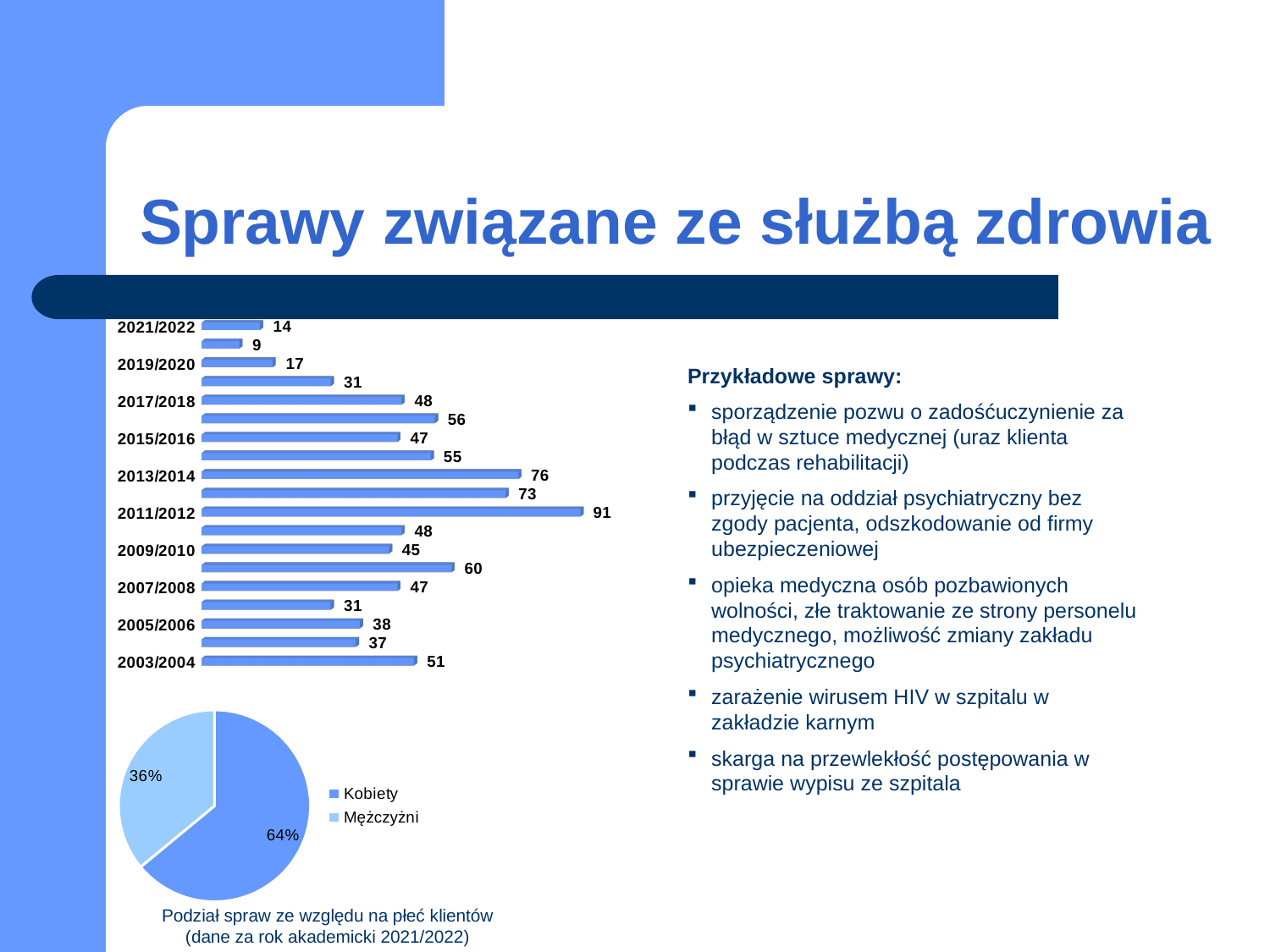
In the bar chart, do the values rise or fall from 2011/2012 to 2021/2022? fall In the pie chart, what share is Mężczyźni? 36% How many entries does the legend of the pie chart list? 2 In the bar chart, what is the difference between the values for 2013/2014 and 2015/2016? 29 In the bar chart, which is larger: the value for 2007/2008 or the value for 2005/2006? 2007/2008 In the pie chart, what share is Kobiety? 64% In the bar chart, what is the value for 2003/2004? 51 In the bar chart, what is the value for 2021/2022? 14 How many bars are plotted in the bar chart? 19 In the bar chart, which labelled year has the highest value? 2011/2012 In the bar chart, what is the value for 2011/2012? 91 What kind of chart is the chart at the top left of the slide? bar chart